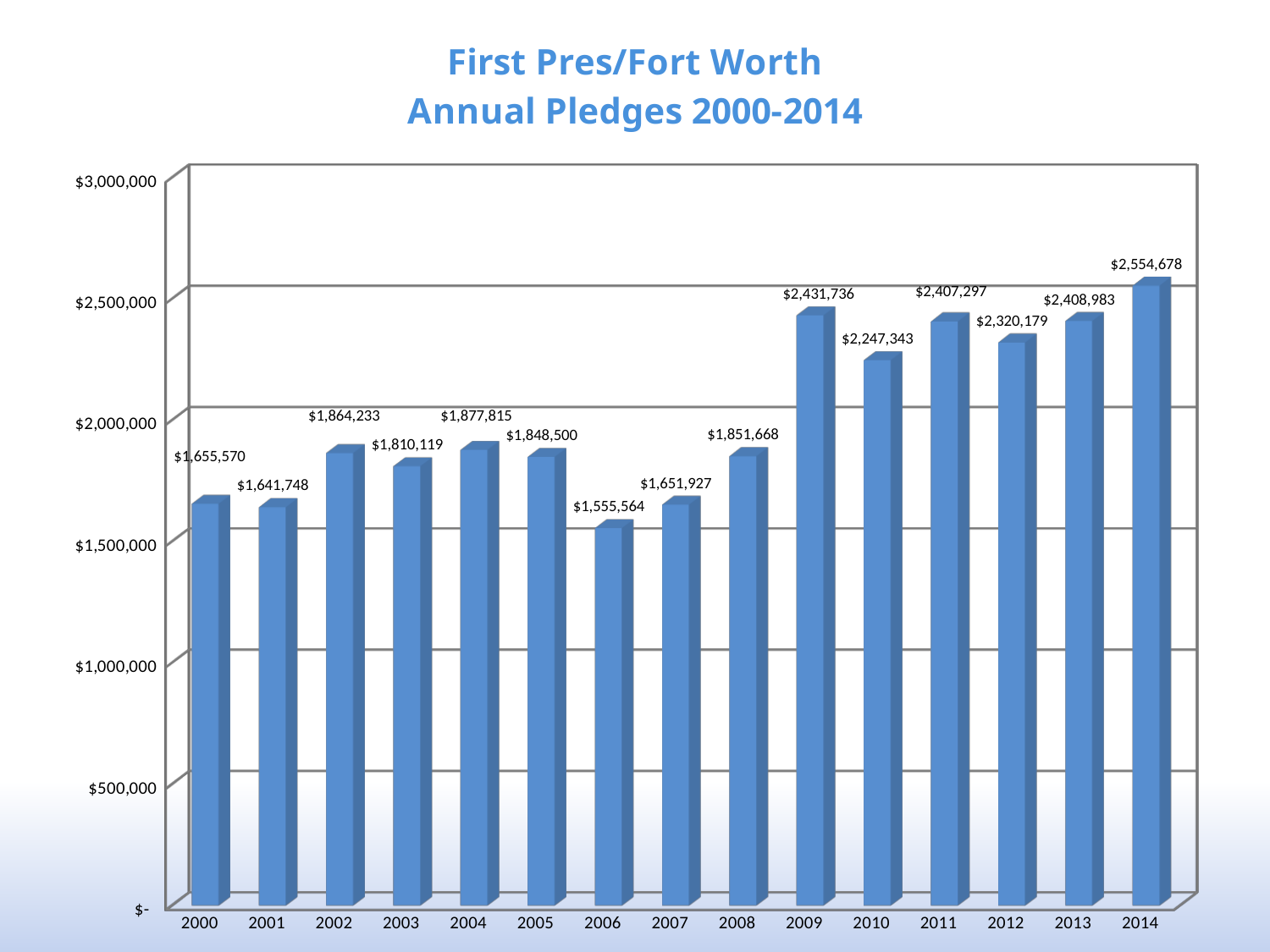
What was the annual pledge value for 2009? $2,431,736 Which year had the lowest annual pledges? 2006 What was the annual pledge value for 2006? $1,555,564 What was the annual pledge value for 2014? $2,554,678 What kind of chart is shown on the slide? Bar chart Which year had larger pledges, 2009 or 2010? 2009 Which year had the highest annual pledges? 2014 What is the title of the chart? First Pres/Fort Worth Annual Pledges 2000-2014 Is the value for 2012 greater or less than $2,000,000? greater How many years are shown on the x axis? 15 What is the difference between the pledges in 2009 and 2008? $580,068 What is the difference between the pledges in 2014 and 2013? $145,695